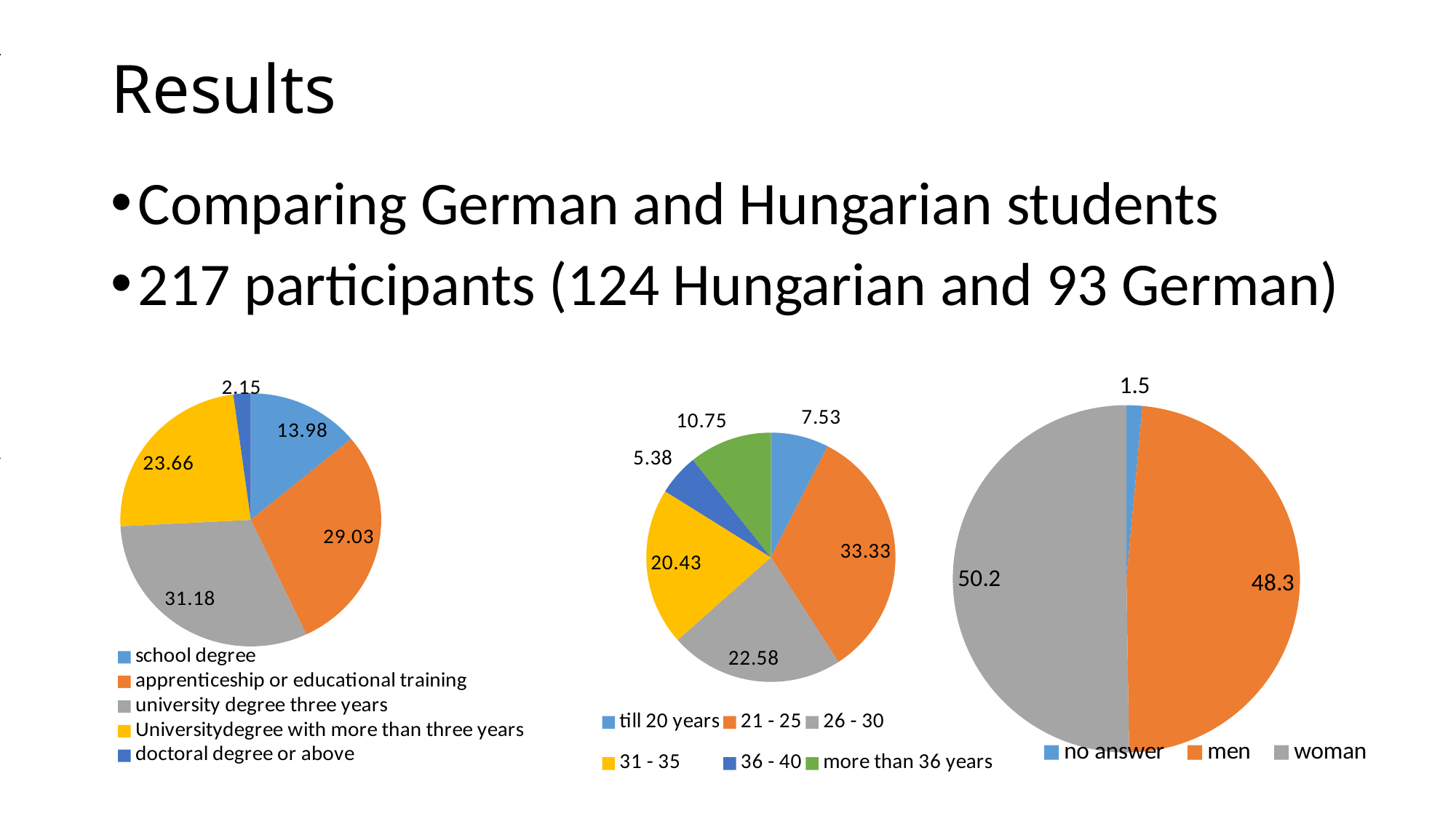
What type of chart is the right chart on the slide? pie chart In the middle pie chart, what is the value for the 31 - 35 age group? 20.43 In the right pie chart, which category has the smallest slice? no answer In the right pie chart, what is the value for men? 48.3 In the right pie chart, what is the difference between the values for woman and men? 1.9 How many categories does the middle pie chart show? 6 In the left pie chart, what is the difference between the values for apprenticeship or educational training and school degree? 15.05 In the middle pie chart, which is larger: the value for 26 - 30 or the value for more than 36 years? 26 - 30 In the middle pie chart, which age group has the largest slice? 21 - 25 How many categories does the left pie chart show? 5 In the left pie chart, what is the value for university degree three years? 31.18 In the left pie chart, which category has the smallest slice? doctoral degree or above